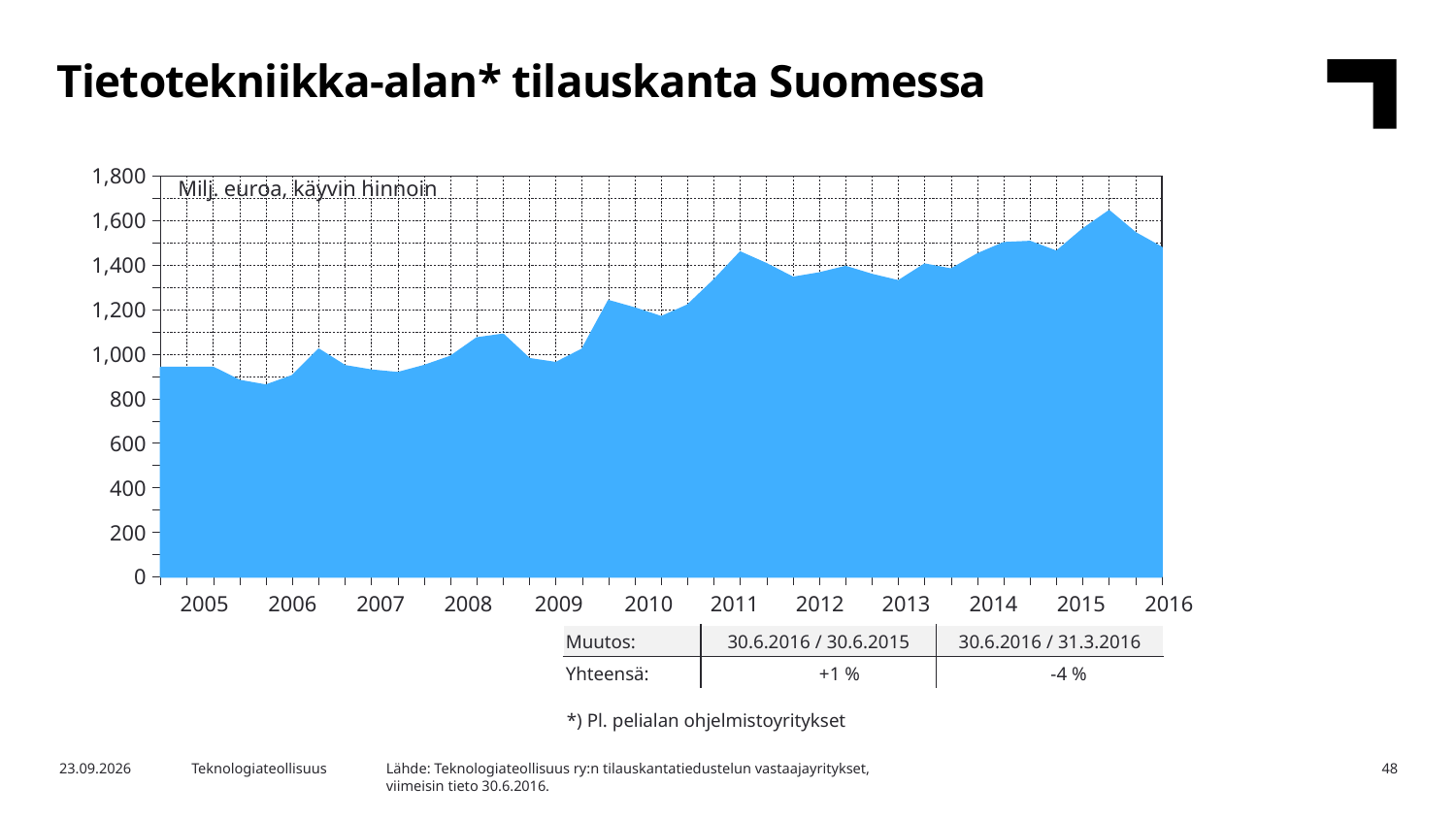
Is the value at the end of the series in 2016 greater or less than 1,200? greater Does the order backlog overall rise or fall from 2005 to 2016? Rise What is the change shown for 30.6.2016 / 30.6.2015 in the table below the chart? +1 % In which year does the order backlog reach its lowest point? 2006 What unit is the chart's data expressed in, according to the label inside the plot area? Milj. euroa, käyvin hinnoin Is the peak value in 2015 greater or less than 1,400? greater How many years are labelled on the x axis? 12 What kind of chart is shown on the slide? Area chart What is the title of the chart? Tietotekniikka-alan* tilauskanta Suomessa Which is larger, the order backlog at the start of 2009 or at the start of 2012? 2012 In which year does the order backlog reach its highest point? 2015 Is the value at the start of 2005 greater or less than 1,000? less